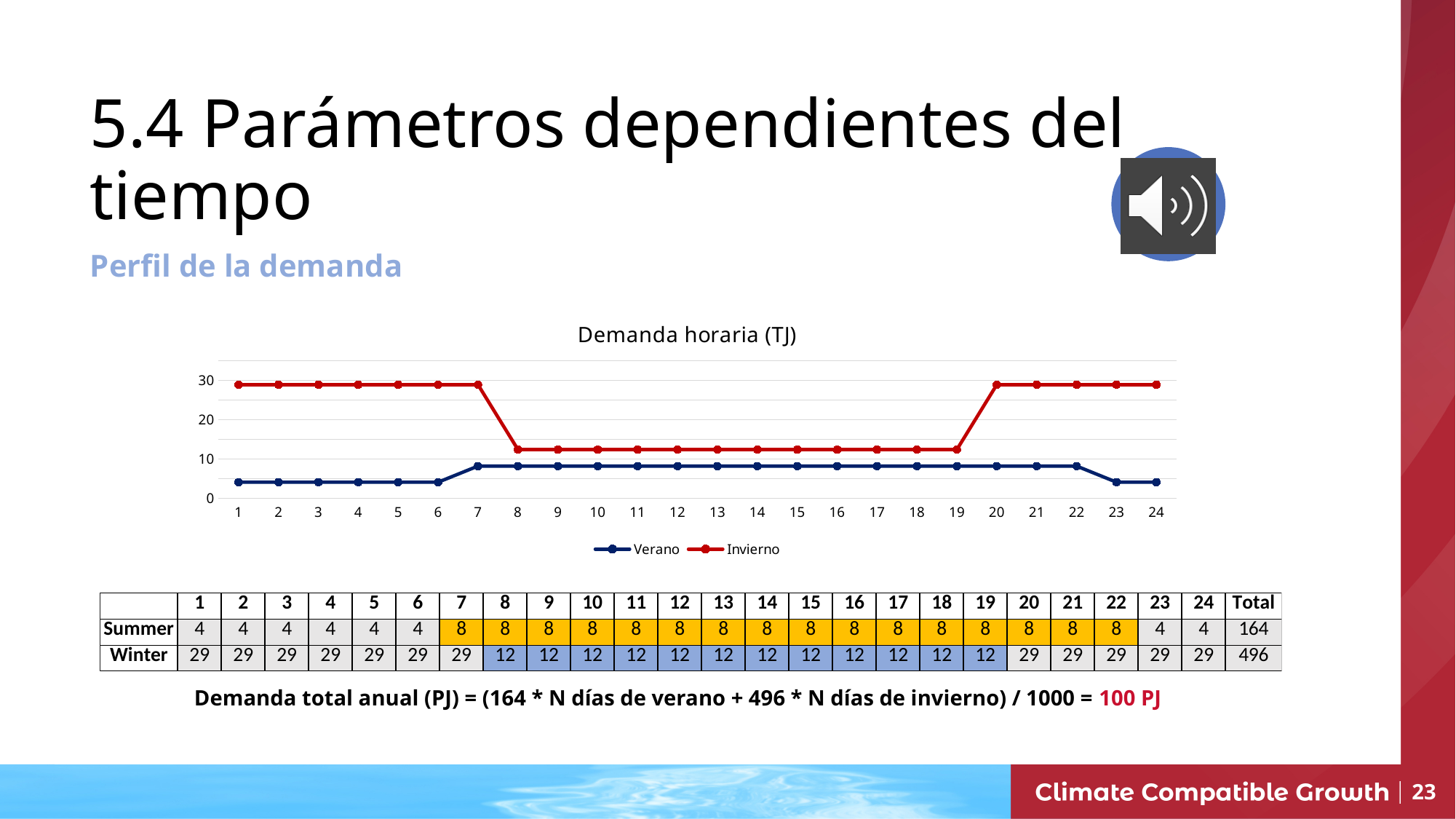
How many hours (points) are plotted along the x axis of the chart? 24 What colour is the Invierno line in the chart? red What is the Verano demand value at hour 12? 8 What is the title of the chart? Demanda horaria (TJ) What is the Invierno demand value at hour 1? 29 Is the Invierno value at hour 3 greater or less than 20? greater Is the Verano value at hour 10 greater or less than 10? less At hour 12, which series has the larger value, Verano or Invierno? Invierno Does the Invierno line rise or fall between hour 7 and hour 8? fall How many series does the legend of the chart list? 2 What kind of chart is shown on the slide? line chart What is the difference between the Invierno and Verano values at hour 1? 25